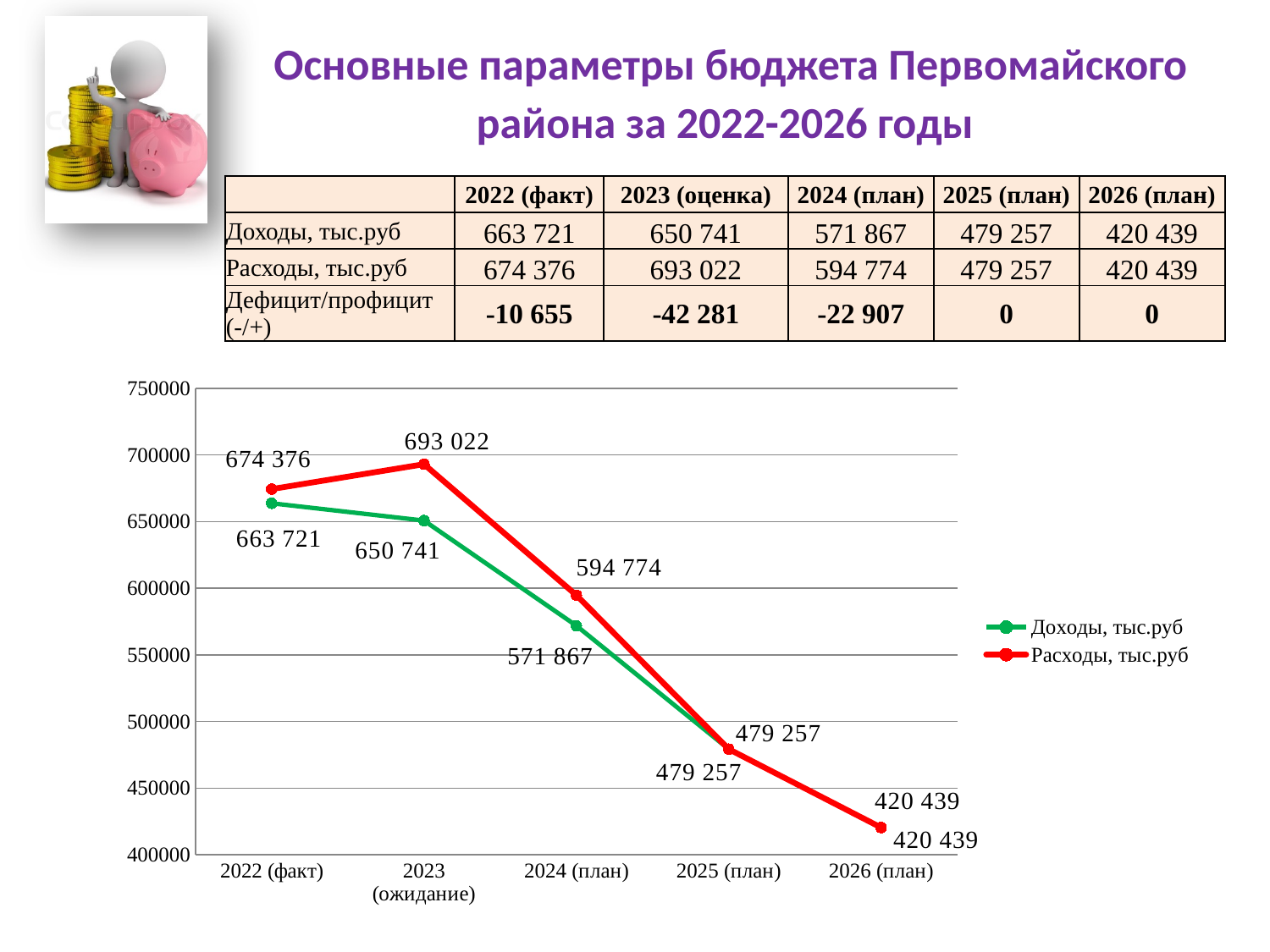
What is the value of Доходы, тыс.руб for 2022 (факт)? 663 721 What is the difference between Расходы and Доходы in 2023 (ожидание)? 42 281 In which year does Расходы, тыс.руб reach its highest value? 2023 (ожидание) Which colour is used for the Расходы, тыс.руб line? red How many series does the chart legend list? 2 In which year is Доходы, тыс.руб lowest? 2026 (план) What is the value of Доходы, тыс.руб for 2024 (план)? 571 867 Which is larger in 2022 (факт): Доходы or Расходы? Расходы How many points are plotted along the x axis for each series? 5 What is the value of Расходы, тыс.руб for 2023 (ожидание)? 693 022 What type of chart is shown on the slide? line chart Do the values of Доходы, тыс.руб rise or fall from 2022 (факт) to 2026 (план)? fall